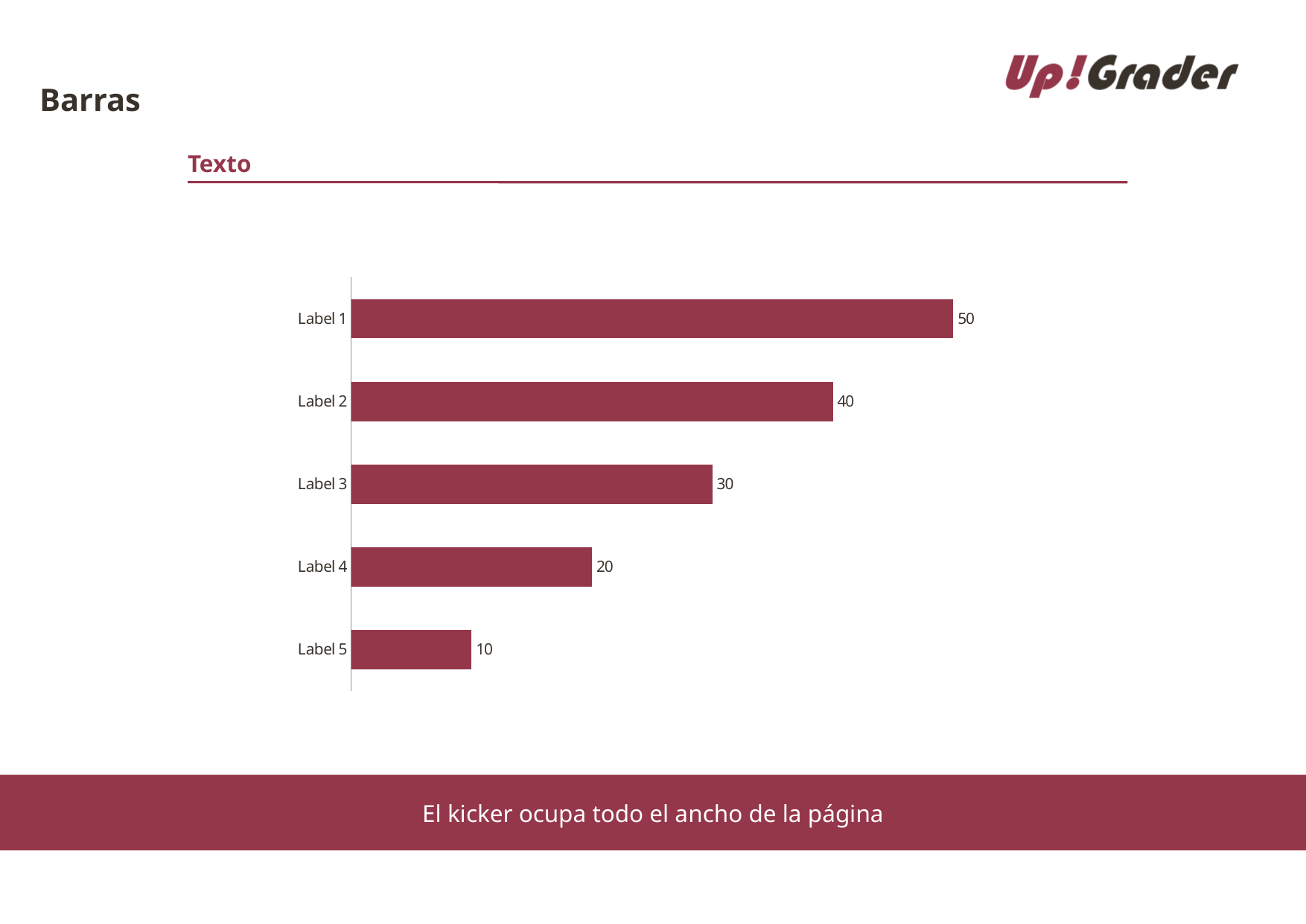
Do the values increase or decrease going from Label 1 down to Label 5? Decrease What is the value for Label 5? 10 How many categories are shown in the chart? 5 What is the value for Label 3? 30 What is the value for Label 1? 50 Which category has the highest value? Label 1 What kind of chart is shown on the slide? Bar chart Which is larger, the value for Label 3 or the value for Label 4? Label 3 What is the difference between the values for Label 2 and Label 4? 20 Which category has the lowest value? Label 5 What is the difference between the values for Label 1 and Label 5? 40 What is the title of the slide? Barras